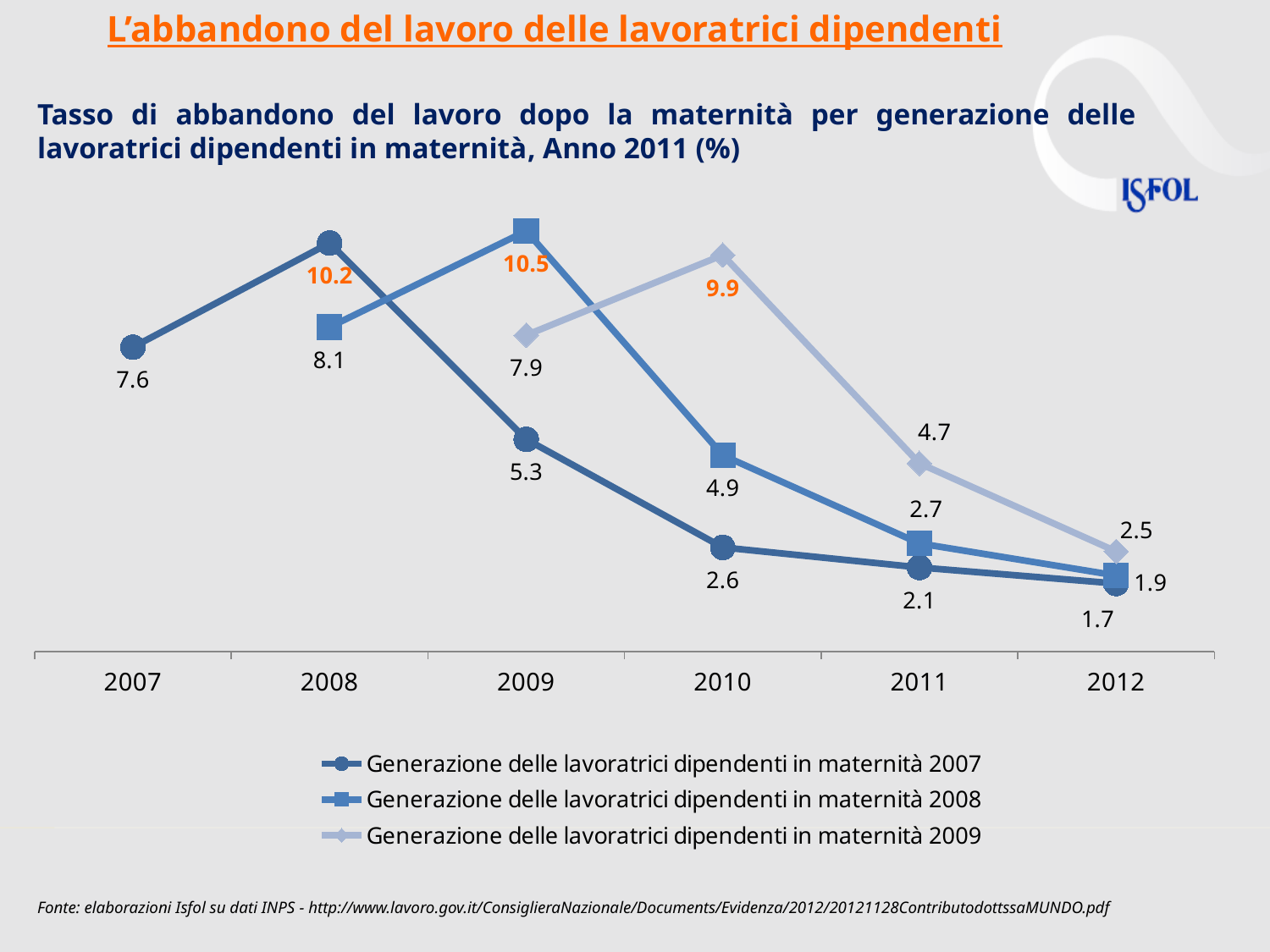
How many series does the legend list? 3 What is the value for the 2009 generation (Generazione delle lavoratrici dipendenti in maternità 2009) in 2012? 2.5 In which year does the 2008 generation series reach its lowest value? 2012 Which is larger in 2011: the value for the 2009 generation or the value for the 2007 generation? 2009 generation What type of chart is shown on the slide? Line chart Does the 2007 generation series rise or fall from 2008 to 2012? Fall What is the value for the 2008 generation (Generazione delle lavoratrici dipendenti in maternità 2008) in 2009? 10.5 What is the title of the chart? Tasso di abbandono del lavoro dopo la maternità per generazione delle lavoratrici dipendenti in maternità, Anno 2011 (%) How many years are shown on the x axis? 6 In which year does the 2007 generation series reach its highest value? 2008 What is the value for the 2007 generation (Generazione delle lavoratrici dipendenti in maternità 2007) in 2008? 10.2 What is the difference between the 2008 generation value in 2009 (10.5) and the 2007 generation value in 2008 (10.2)? 0.3